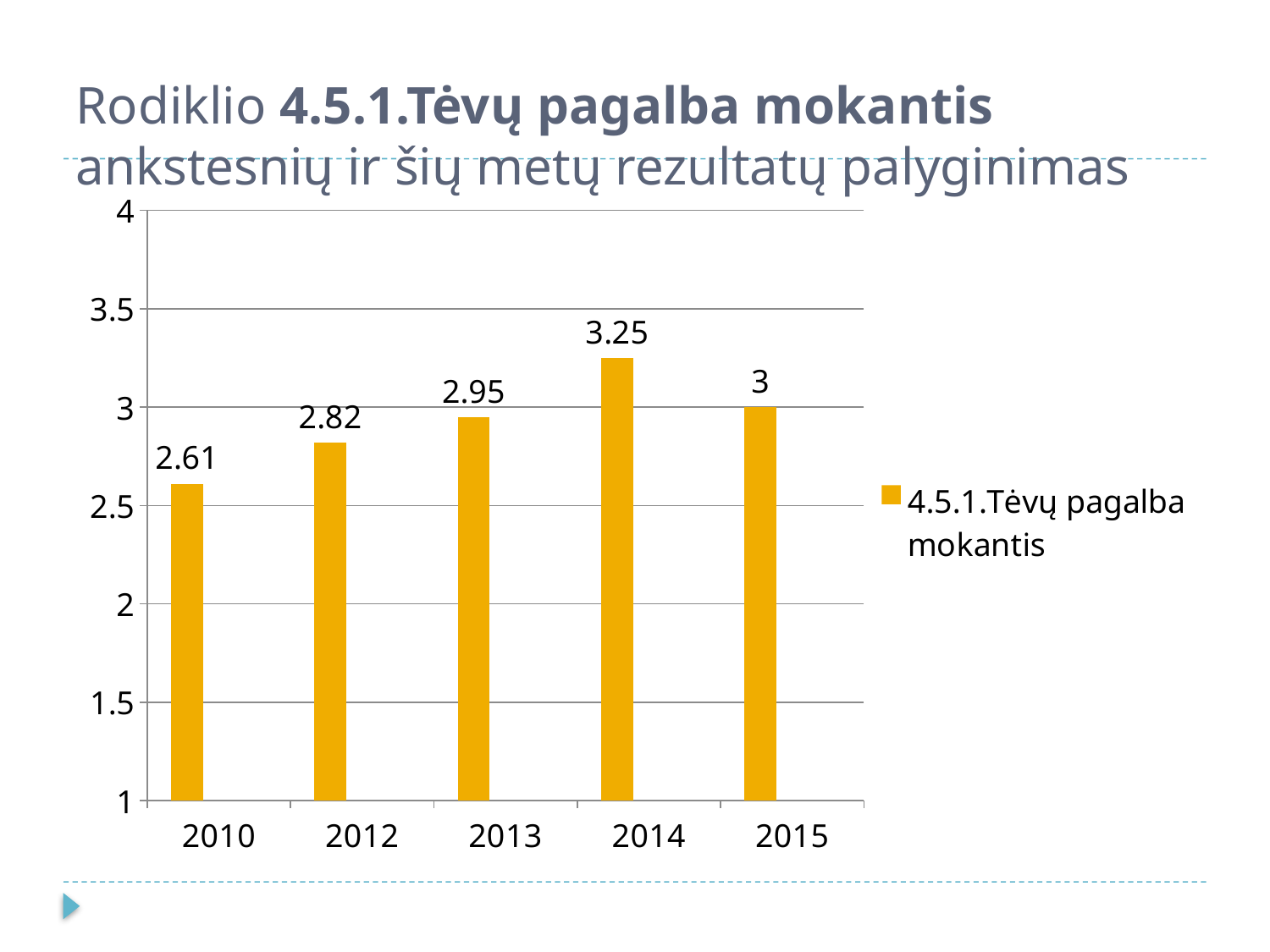
What is the value for 2015? 3 Which is larger, the value for 2013 or the value for 2015? 2015 What is the value for 2014? 3.25 How many years are shown on the x axis? 5 What is the difference between the values for 2012 and 2010? 0.21 Which year has the highest value? 2014 What series name does the legend list? 4.5.1.Tėvų pagalba mokantis Which year has the lowest value? 2010 What is the value for 2010? 2.61 Is the value for 2012 greater or less than 3? less What kind of chart is shown on the slide? bar chart What is the difference between the values for 2014 and 2013? 0.3